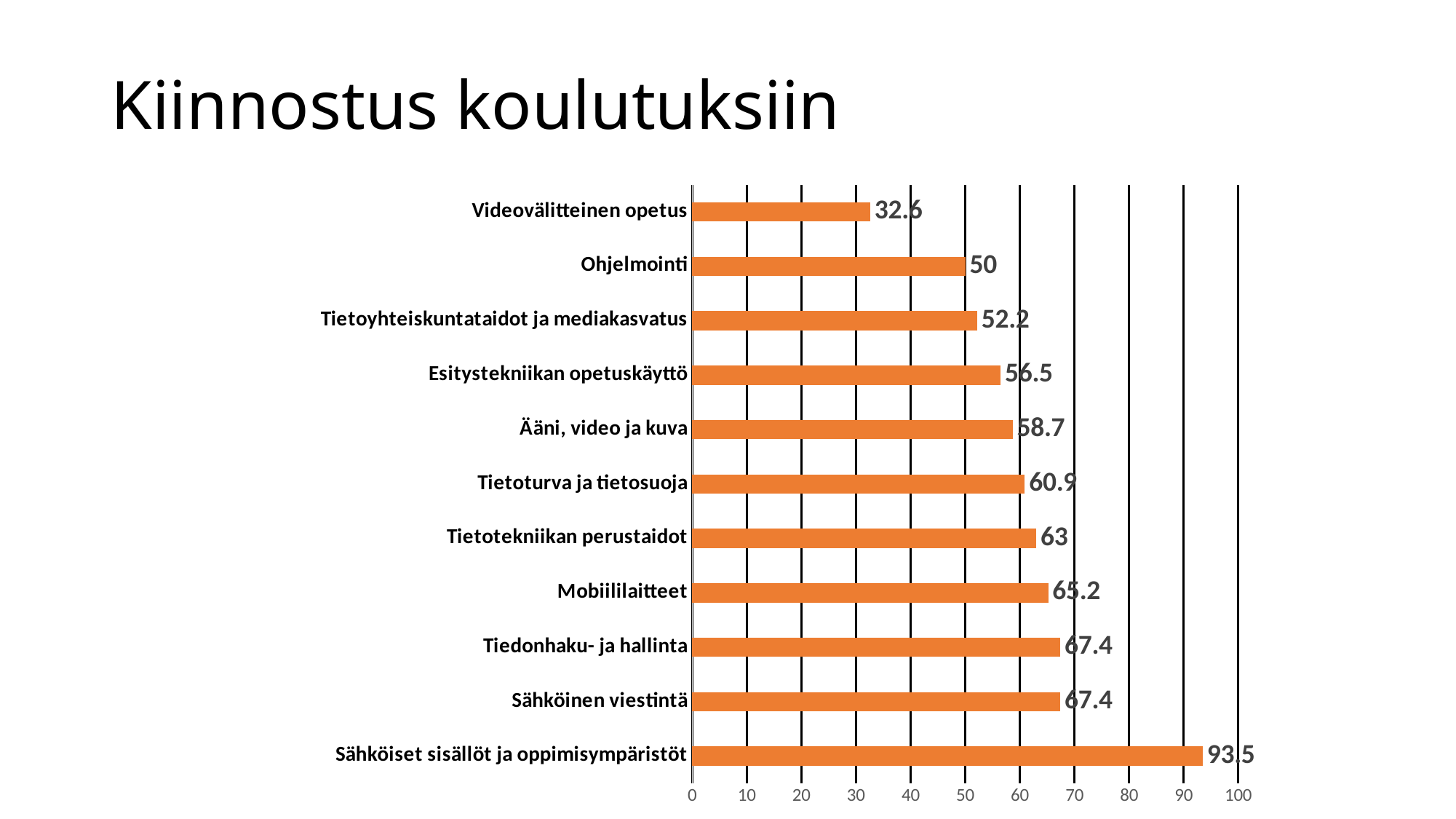
What kind of chart is shown on the slide? bar chart What is the title of the slide? Kiinnostus koulutuksiin Which category has the lowest value? Videovälitteinen opetus What is the difference between the values for Sähköiset sisällöt ja oppimisympäristöt and Videovälitteinen opetus? 60.9 What is the value for Tietoturva ja tietosuoja? 60.9 Is the value for Esitystekniikan opetuskäyttö greater or less than 50? greater What is the difference between the values for Mobiililaitteet and Tietotekniikan perustaidot? 2.2 Which category has the highest value? Sähköiset sisällöt ja oppimisympäristöt How many categories are shown in the chart? 11 What is the value for Ohjelmointi? 50 What is the value for Sähköiset sisällöt ja oppimisympäristöt? 93.5 Which is larger, the value for Ääni, video ja kuva or the value for Ohjelmointi? Ääni, video ja kuva